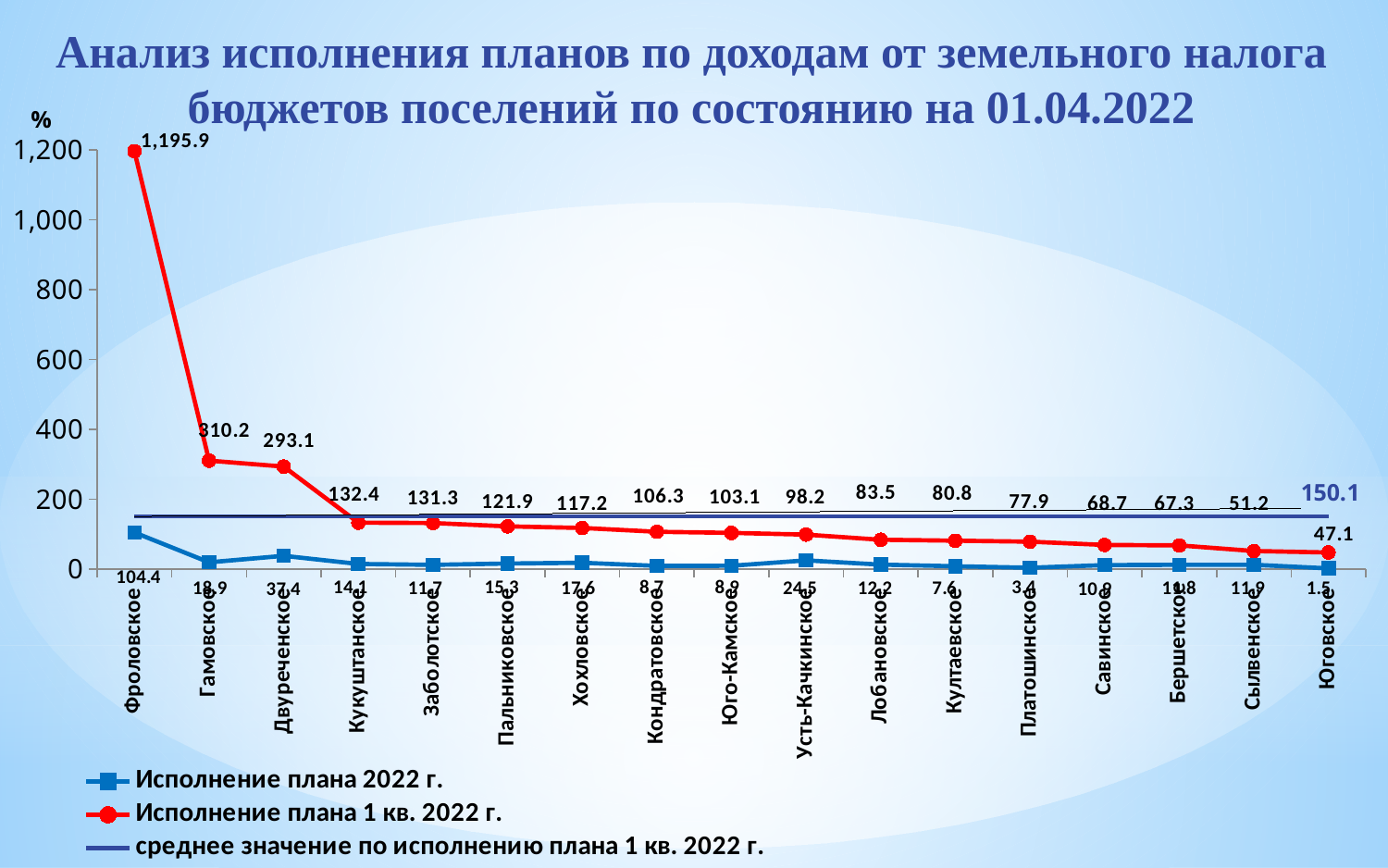
Which settlement has the lowest value in the series "Исполнение плана 1 кв. 2022 г."? Юговское What is the value of the series "Исполнение плана 2022 г." for Фроловское? 104.4 What is the difference between the "Исполнение плана 1 кв. 2022 г." values for Гамовское and Двуреченское? 17.1 Does the series "Исполнение плана 1 кв. 2022 г." rise or fall from left to right along the x axis? Fall Which settlement has the highest value in the series "Исполнение плана 1 кв. 2022 г."? Фроловское What is the value of the series "Исполнение плана 1 кв. 2022 г." for Кукуштанское? 132.4 What is the value of the series "Исполнение плана 1 кв. 2022 г." for Фроловское? 1,195.9 In the series "Исполнение плана 1 кв. 2022 г.", which is larger: Хохловское or Кондратовское? Хохловское How many series does the legend list? 3 What type of chart is shown on the slide? Line chart How many settlements are shown on the x axis? 17 What value does the line "среднее значение по исполнению плана 1 кв. 2022 г." show? 150.1